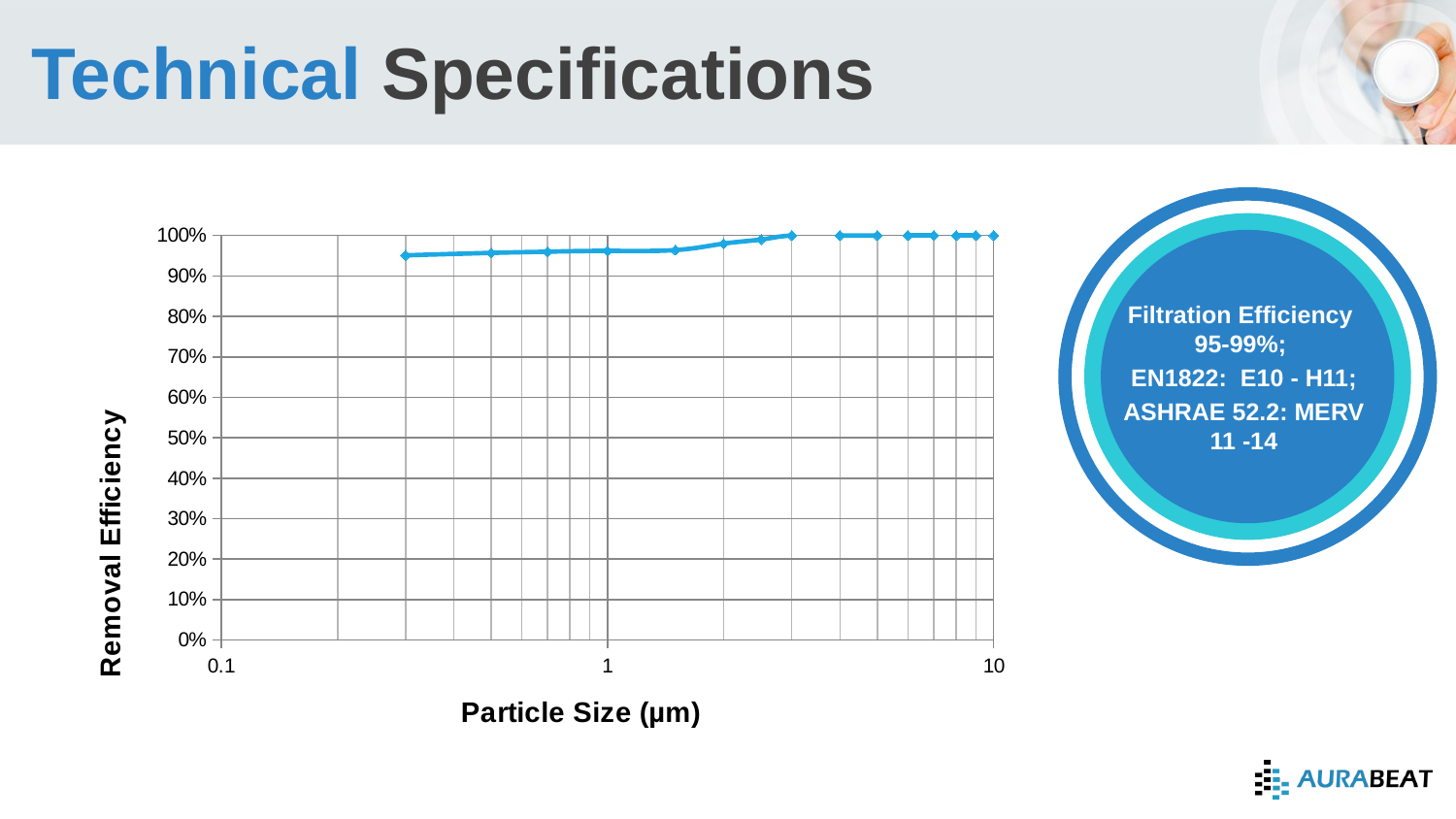
Is the removal efficiency at a particle size of 1 µm greater or less than 90%? greater Is the removal efficiency at the smallest particle size plotted greater or less than 80%? greater What is the highest value shown on the y axis of the chart? 100% What kind of chart is shown on the slide? line chart Is the lowest removal efficiency found at the smallest or the largest particle size plotted? smallest How many data points are plotted on the line? 15 What is the label of the y axis of the chart? Removal Efficiency Which has the higher removal efficiency: a particle size of 10 µm or the smallest particle size plotted? 10 µm Is the removal efficiency at the smallest particle size plotted greater or less than 100%? less What is the label of the x axis of the chart? Particle Size (µm) Does removal efficiency rise or fall as particle size increases along the x axis? rise